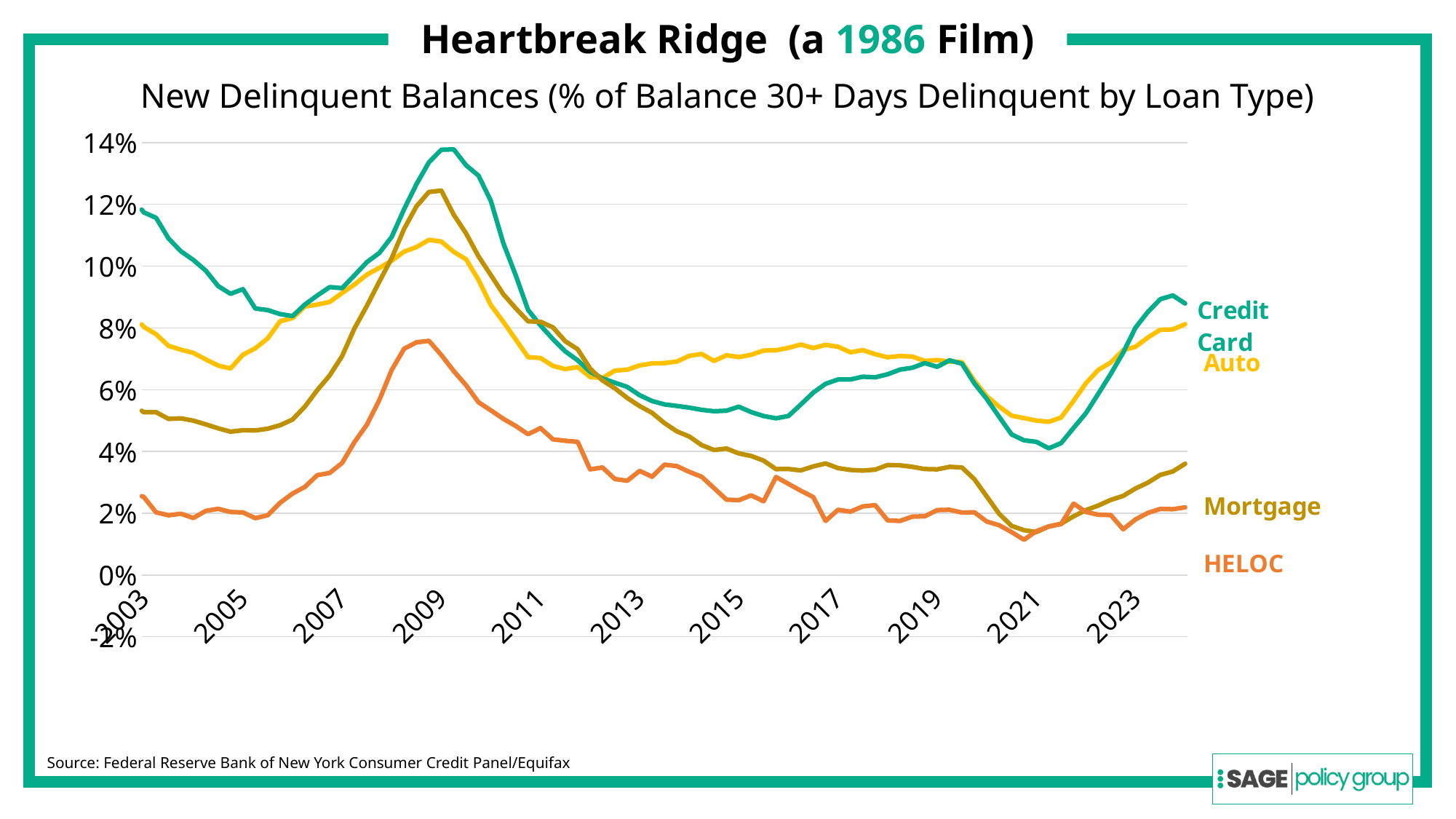
What kind of chart is shown on the slide? Line chart Is the HELOC value at its 2009 peak greater or less than 8%? less Which loan type has the lowest delinquency rate at the right end of the chart? HELOC What source is cited for the chart data? Federal Reserve Bank of New York Consumer Credit Panel/Equifax How many loan-type series are plotted on the chart? 4 Is the Mortgage value in 2021 greater or less than 2%? less At the 2009 peak, which is higher: Mortgage or Auto? Mortgage What is the title of the chart below the slide heading? New Delinquent Balances (% of Balance 30+ Days Delinquent by Loan Type) Which loan type reaches the highest delinquency rate around 2009? Credit Card Is the Auto value in 2017 greater or less than 6%? greater Does the Mortgage line rise or fall between 2021 and 2023? Rises